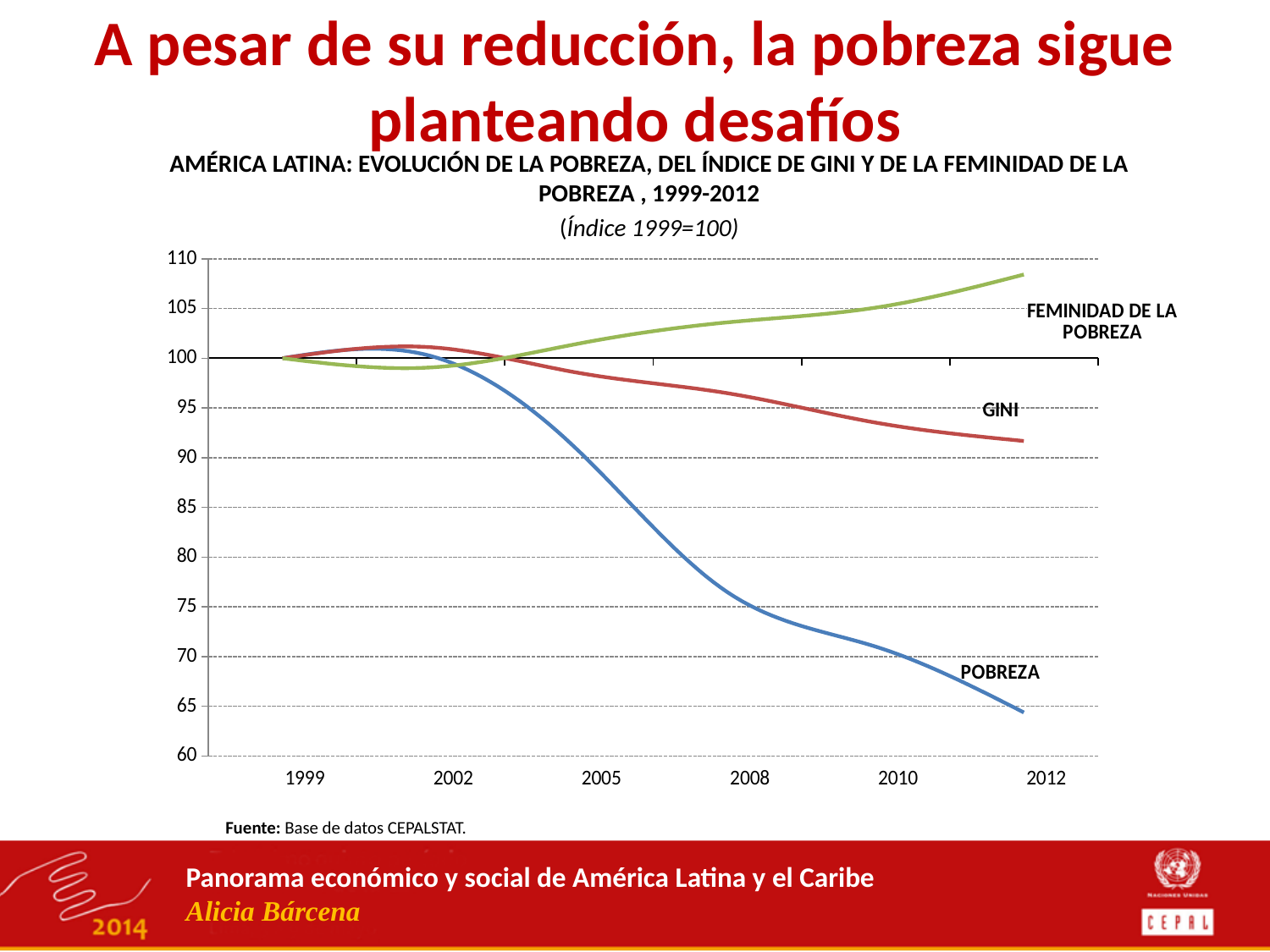
What is the base year of the index used in the chart? 1999 Does the GINI series rise or fall between 2002 and 2012? fall How many series are plotted on the chart? 3 Which series has the highest value in 2012? FEMINIDAD DE LA POBREZA Does the FEMINIDAD DE LA POBREZA series rise or fall between 2002 and 2012? rise Is the value for FEMINIDAD DE LA POBREZA in 2012 greater or less than 105? greater Does the POBREZA series rise or fall between 1999 and 2012? fall Is the value for POBREZA in 2008 greater or less than 80? less Which series has the lowest value in 2012? POBREZA In 2008, which series is larger, GINI or POBREZA? GINI What is the index value of POBREZA in 1999? 100 What kind of chart is shown on the slide? line chart